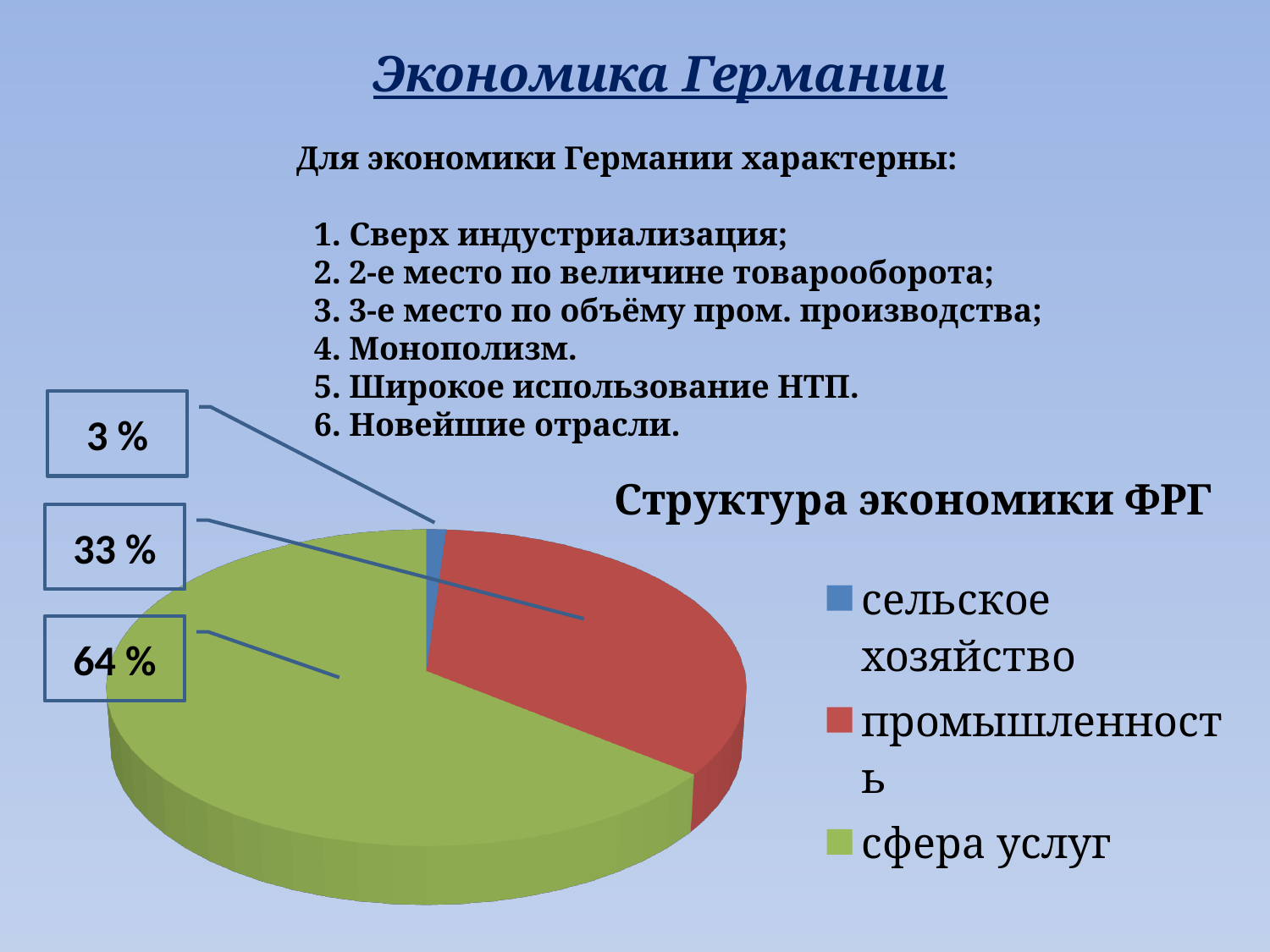
What share of the pie does сельское хозяйство take? 3 % What is the difference in percentage points between сфера услуг and промышленность? 31 Which sector has the largest slice of the pie? сфера услуг What is the title of the chart? Структура экономики ФРГ What kind of chart is shown on the slide? pie chart What share of the pie does промышленность take? 33 % How many slices does the pie chart have? 3 How many entries does the chart legend list? 3 Which is larger, the share of промышленность or the share of сельское хозяйство? промышленность Which sector has the smallest slice of the pie? сельское хозяйство What share of the pie does сфера услуг take? 64 % Which colour represents сфера услуг in the pie chart? green